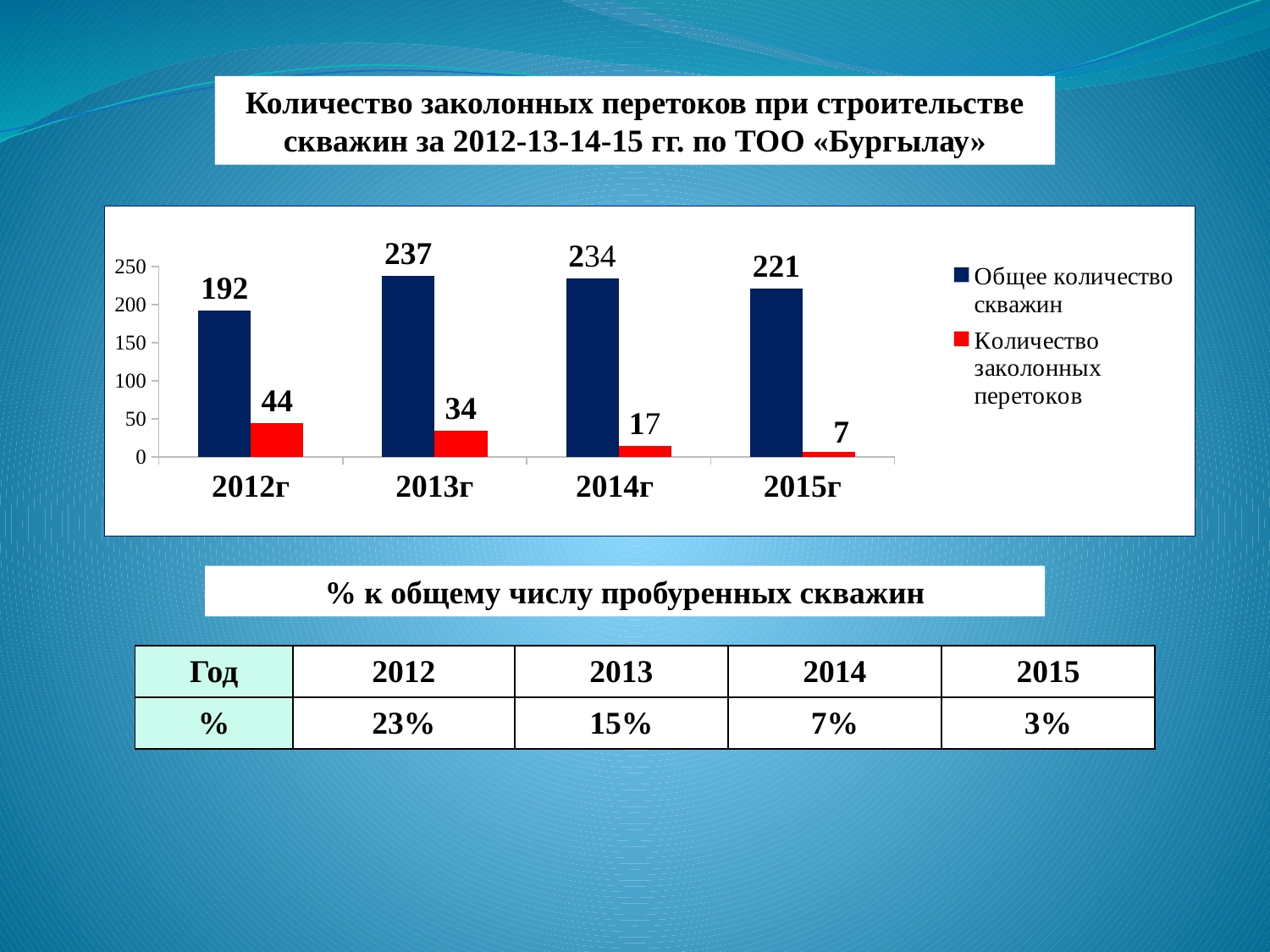
Is the value of "Общее количество скважин" for 2015г greater or less than 200? greater What is the difference between "Общее количество скважин" and "Количество заколонных перетоков" in 2013г? 203 What is the value of "Количество заколонных перетоков" for 2014г? 17 Does the value of "Количество заколонных перетоков" rise or fall from 2012г to 2015г? Fall What is the value of "Количество заколонных перетоков" for 2015г? 7 How many years are shown on the x axis of the chart? 4 Which is larger: "Количество заколонных перетоков" in 2012г or in 2013г? 2012г What kind of chart is shown on the slide? Bar chart How many series does the chart legend list? 2 Which year has the highest value for "Общее количество скважин"? 2013г Which year has the lowest value for "Количество заколонных перетоков"? 2015г What is the value of "Общее количество скважин" for 2012г? 192